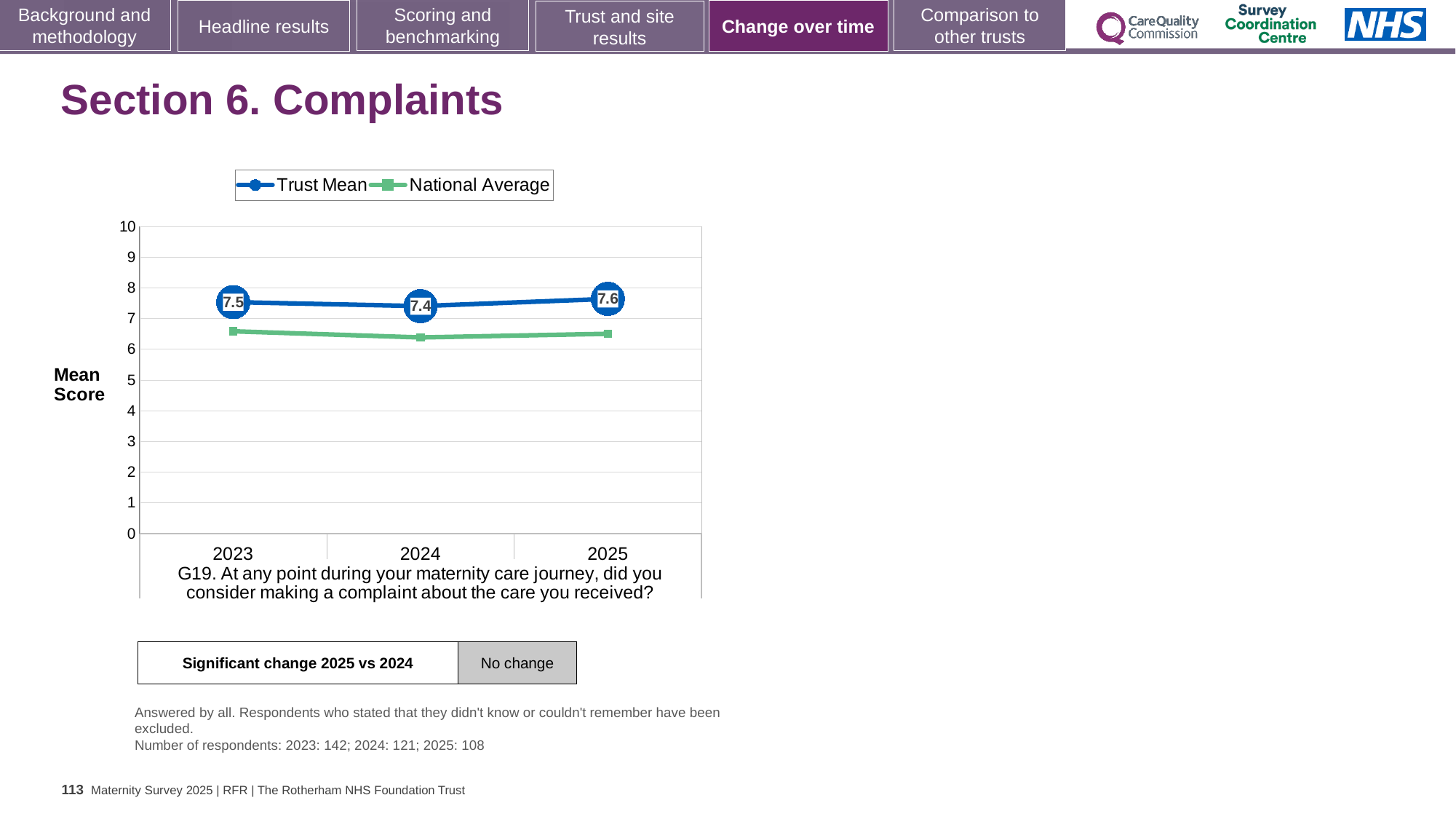
What is the Trust Mean score for 2025? 7.6 Is the National Average value for 2024 greater or less than 6? greater In 2025, which is larger: the Trust Mean or the National Average? Trust Mean What is the Trust Mean score for 2023? 7.5 What is the difference between the Trust Mean scores for 2025 and 2024? 0.2 In which year is the Trust Mean score lowest? 2024 Does the Trust Mean rise or fall from 2024 to 2025? Rise In which year is the Trust Mean score highest? 2025 How many series does the legend list? 2 How many years are plotted on the x axis? 3 What kind of chart is shown on the slide? Line chart Is the National Average value for 2023 greater or less than 7? less